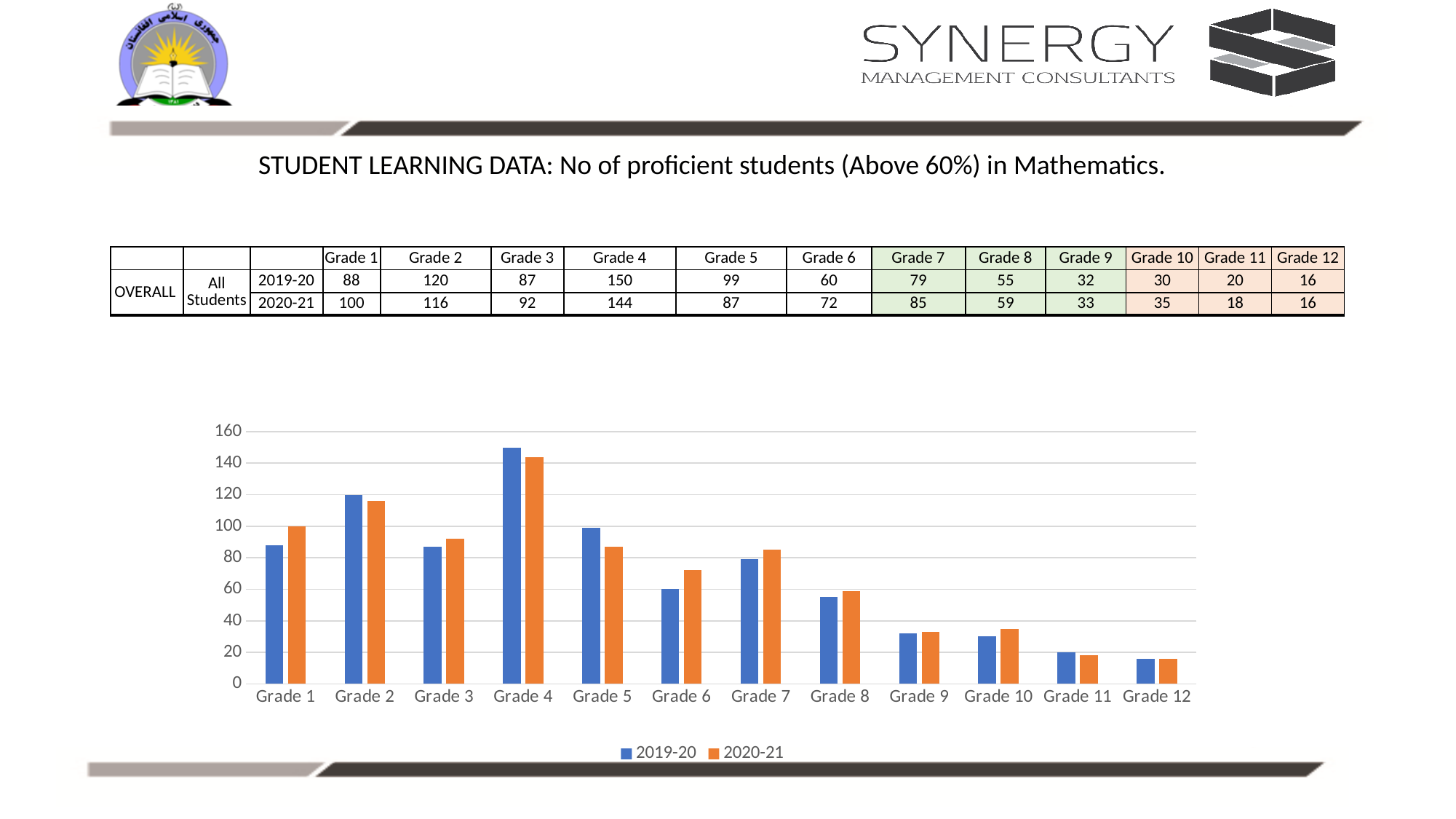
Which grade has the highest value in the 2020-21 series? Grade 4 How many grade categories are plotted on the x axis of the chart? 12 Which grade has the lowest value in the 2019-20 series? Grade 12 What kind of chart is shown on the slide? bar chart How many series does the chart legend list? 2 Do the 2019-20 values generally rise or fall from Grade 7 to Grade 12? fall What is the value for Grade 4 in the 2019-20 series? 150 Is the 2020-21 value for Grade 7 greater or less than 60? greater What is the difference between the 2019-20 and 2020-21 values for Grade 6? 12 Which is larger for Grade 5: the 2019-20 value or the 2020-21 value? 2019-20 Which colour represents the 2020-21 series in the chart? orange What is the value for Grade 1 in the 2020-21 series? 100